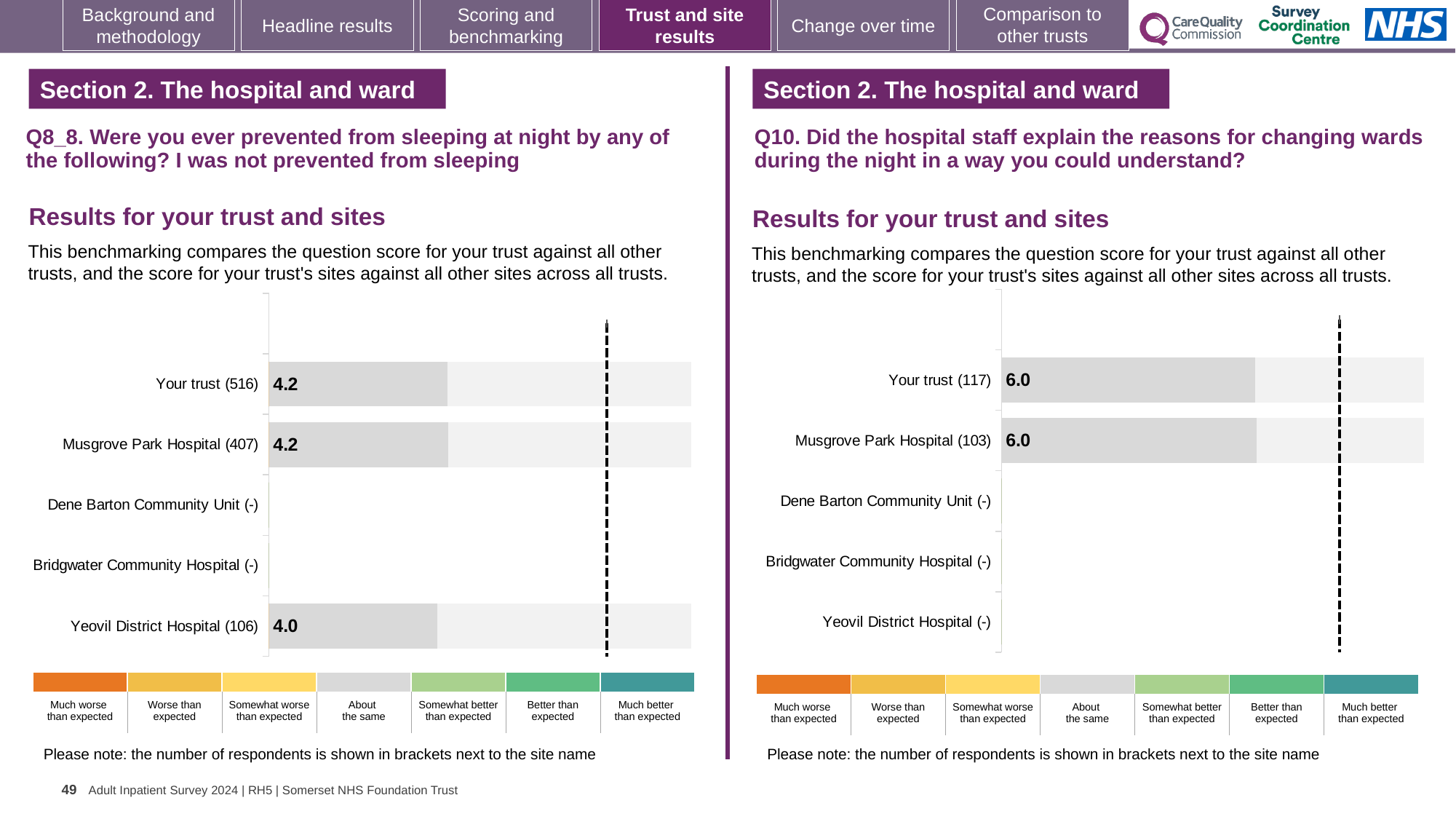
What kind of chart is used on the Q8_8 chart (left)? Bar chart On the Q10 chart (right), what is the score for Your trust? 6.0 On the Q8_8 chart (left), what is the difference between the scores for Musgrove Park Hospital and Yeovil District Hospital? 0.2 On the Q8_8 chart (left), what is the score for Yeovil District Hospital? 4.0 On the Q10 chart (right), how many respondents are shown in brackets for Musgrove Park Hospital? 103 On the Q8_8 chart (left), which site with a plotted score has the lowest value? Yeovil District Hospital On the Q8_8 chart (left), what is the score for Musgrove Park Hospital? 4.2 On the Q10 chart (right), what is the score for Musgrove Park Hospital? 6.0 How many site/trust categories are listed on the Q10 chart (right)? 5 On the Q8_8 chart (left), which is larger, the score for Your trust or the score for Yeovil District Hospital? Your trust On the Q8_8 chart (left), what is the score for Your trust? 4.2 On the Q8_8 chart (left), how many respondents are shown in brackets for Your trust? 516